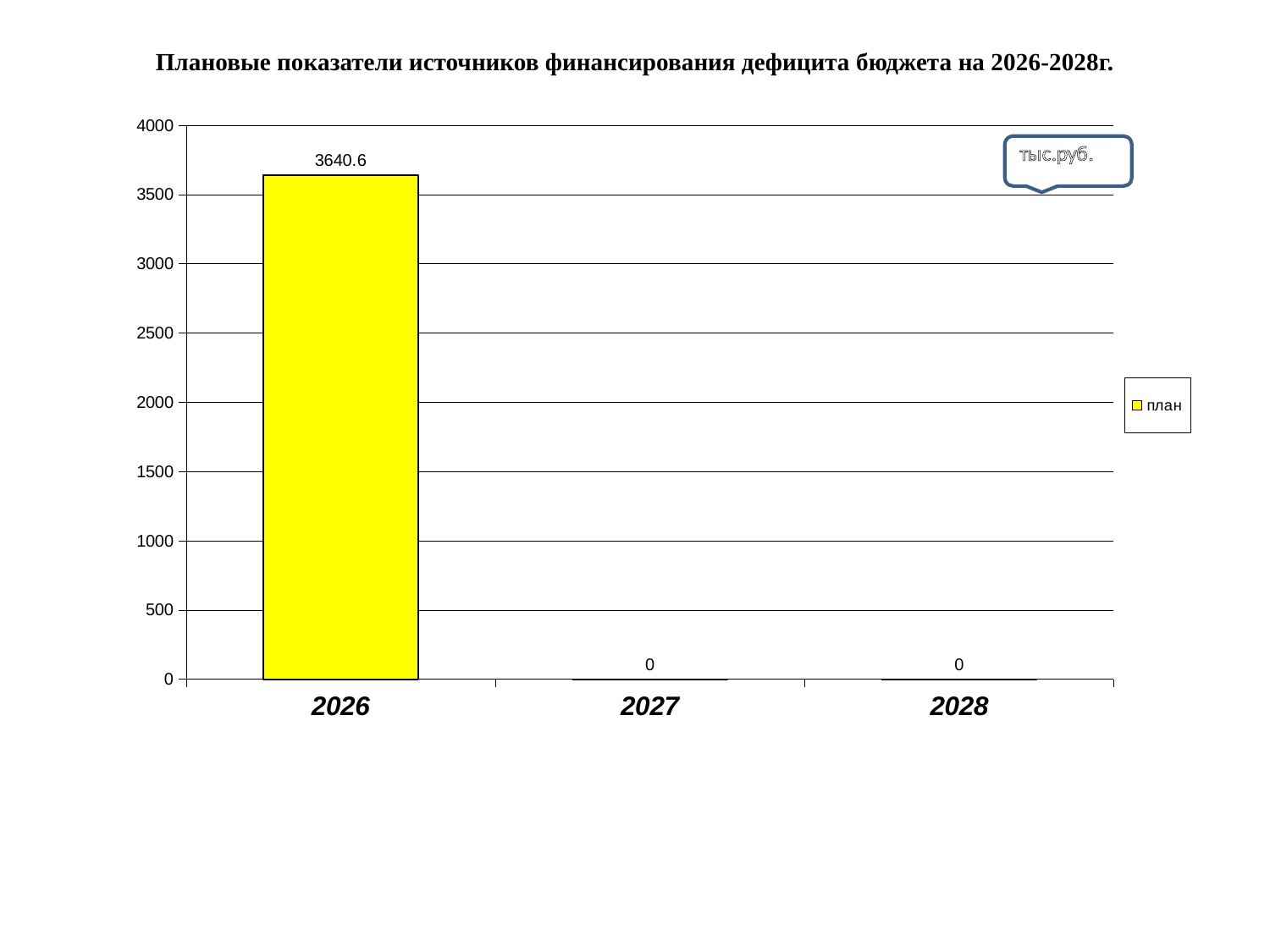
What kind of chart is shown? bar chart What is the value for 2028? 0 What is the value for 2026? 3640.6 Is the value for 2026 greater or less than 3500? greater Which year has the highest value? 2026 Do the values rise or fall from 2026 to 2028? fall What is the difference between the values for 2026 and 2027? 3640.6 How many series does the legend list? 1 How many years are shown on the x axis? 3 Which is larger, the value for 2026 or the value for 2028? 2026 What is the name of the series in the legend? план What is the value for 2027? 0